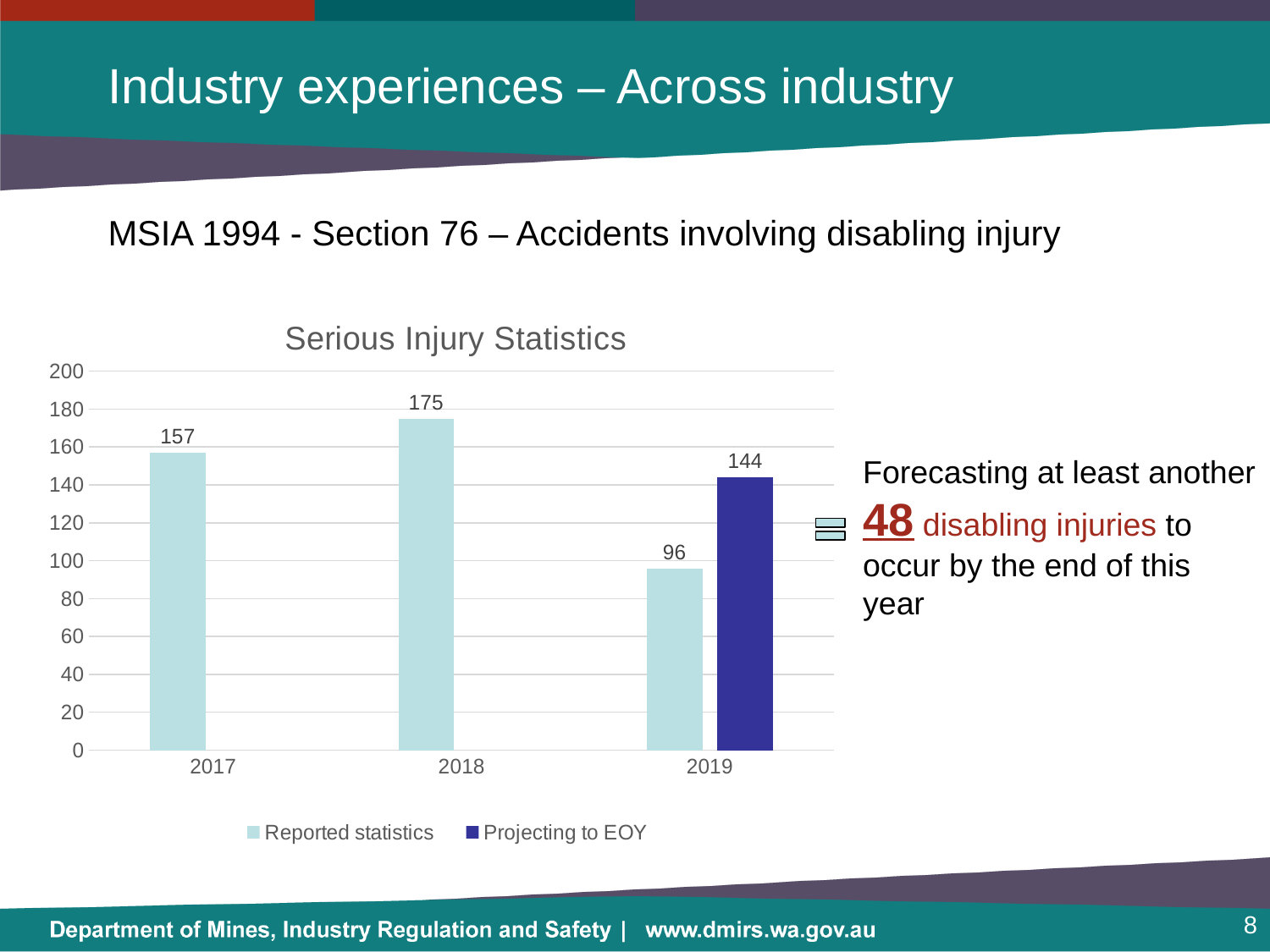
Which is larger: the Reported statistics value for 2017 or the Projecting to EOY value for 2019? Reported statistics for 2017 What is the Projecting to EOY value for 2019? 144 Which year has the highest Reported statistics value? 2018 How many series does the legend list? 2 What is the Reported statistics value for 2017? 157 What type of chart is shown? Bar chart Which year has the lowest Reported statistics value? 2019 How many years are shown on the x axis? 3 What is the difference between the Reported statistics values for 2018 and 2017? 18 What is the Reported statistics value for 2018? 175 What is the difference between the Projecting to EOY value and the Reported statistics value for 2019? 48 What is the Reported statistics value for 2019? 96